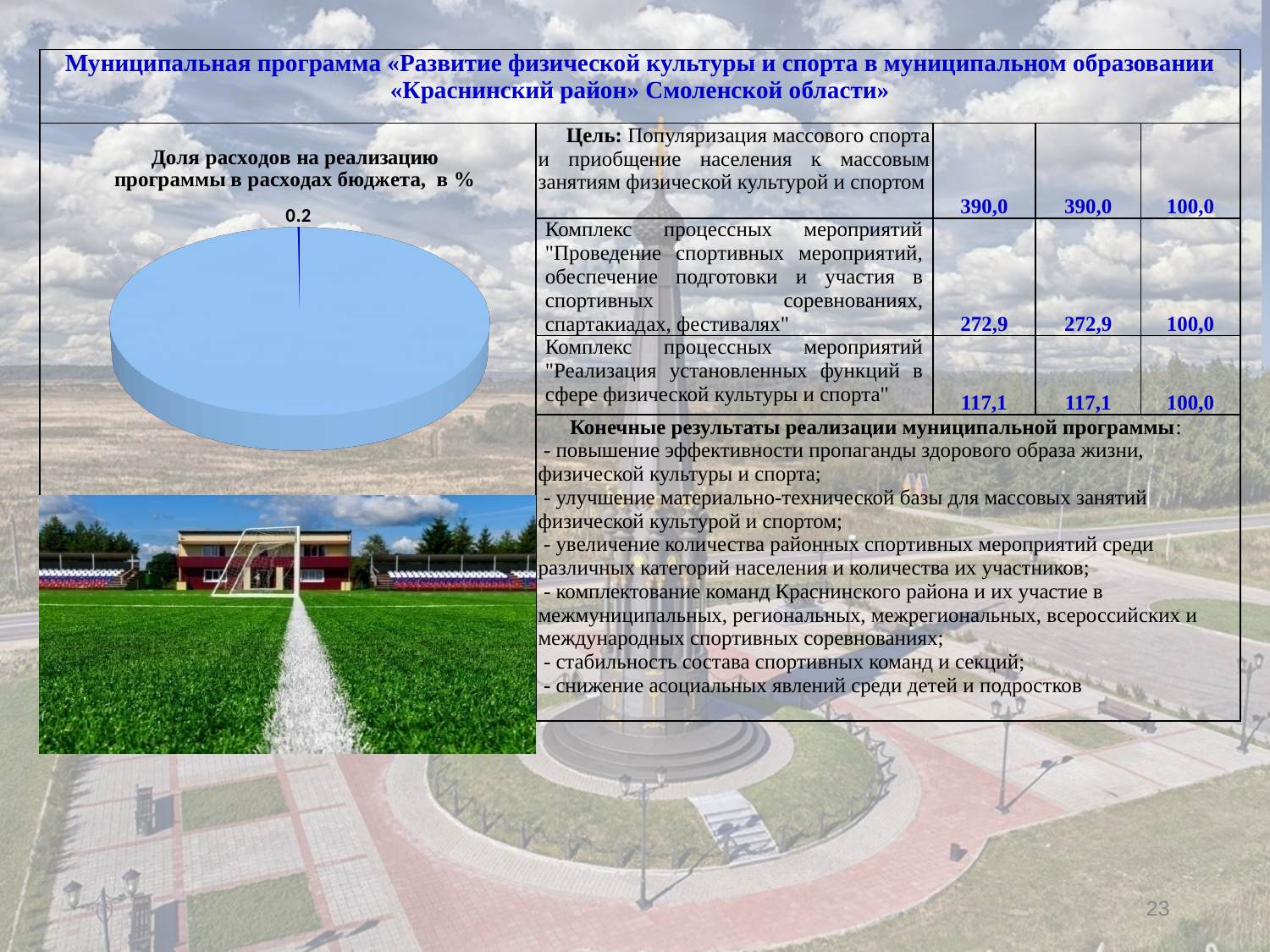
What kind of chart is shown on the left of the slide? pie chart What colour is the large slice of the pie chart? light blue What value is printed as a data label on the pie chart? 0.2 What is the title of the pie chart on the slide? Доля расходов на реализацию программы в расходах бюджета, в %